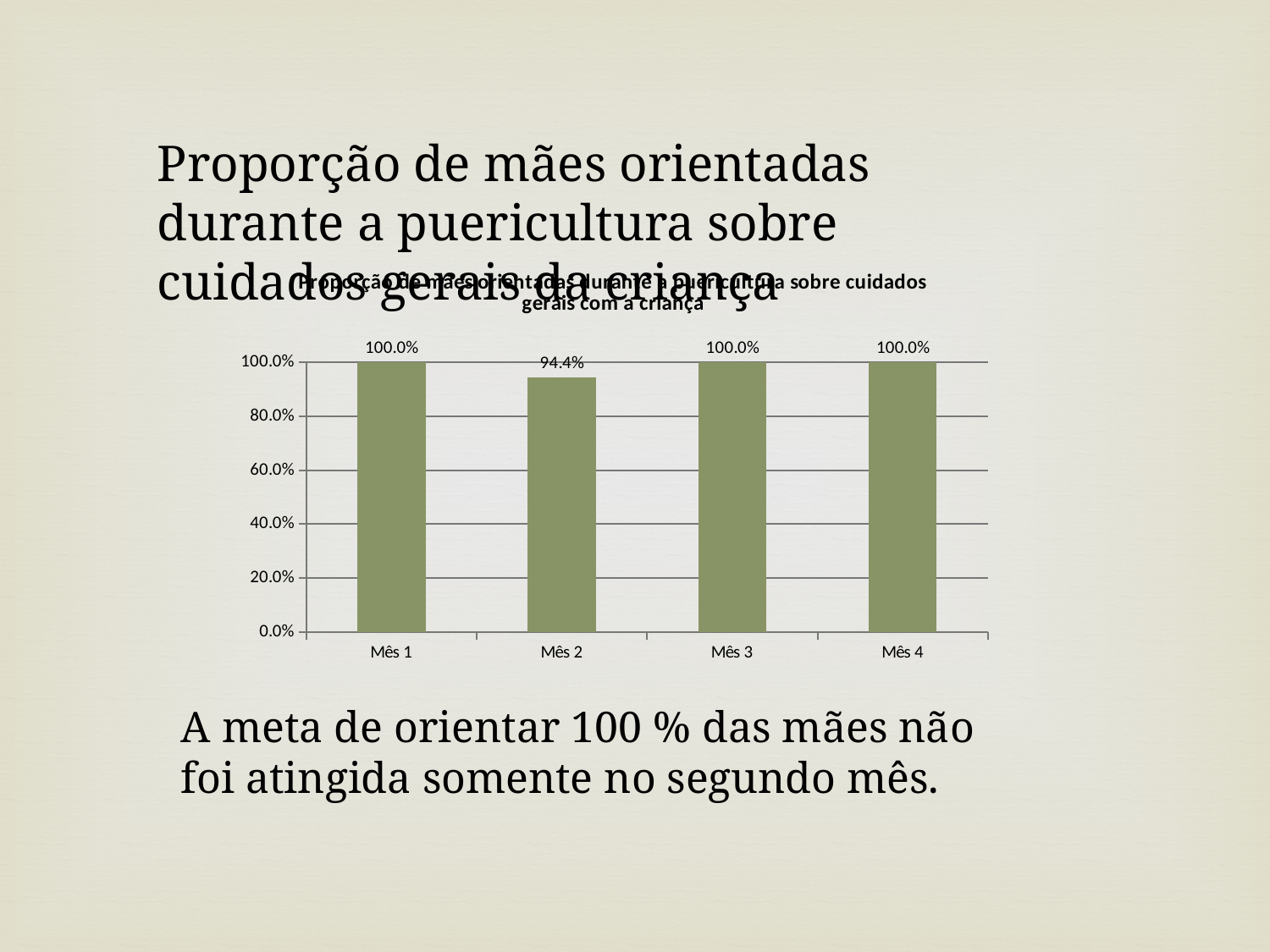
How many months are shown on the x axis? 4 What is the value for Mês 4? 100.0% What is the value for Mês 2? 94.4% Which is larger, the value for Mês 2 or the value for Mês 3? Mês 3 What is the value for Mês 1? 100.0% What kind of chart is shown on the slide? bar chart What is the highest value shown on the y axis? 100.0% What is the difference between the values for Mês 1 and Mês 2? 5.6% Which month has the lowest value? Mês 2 What colour are the bars in the chart? green How many months reach 100.0%? 3 Is the value for Mês 2 greater or less than 80.0%? greater